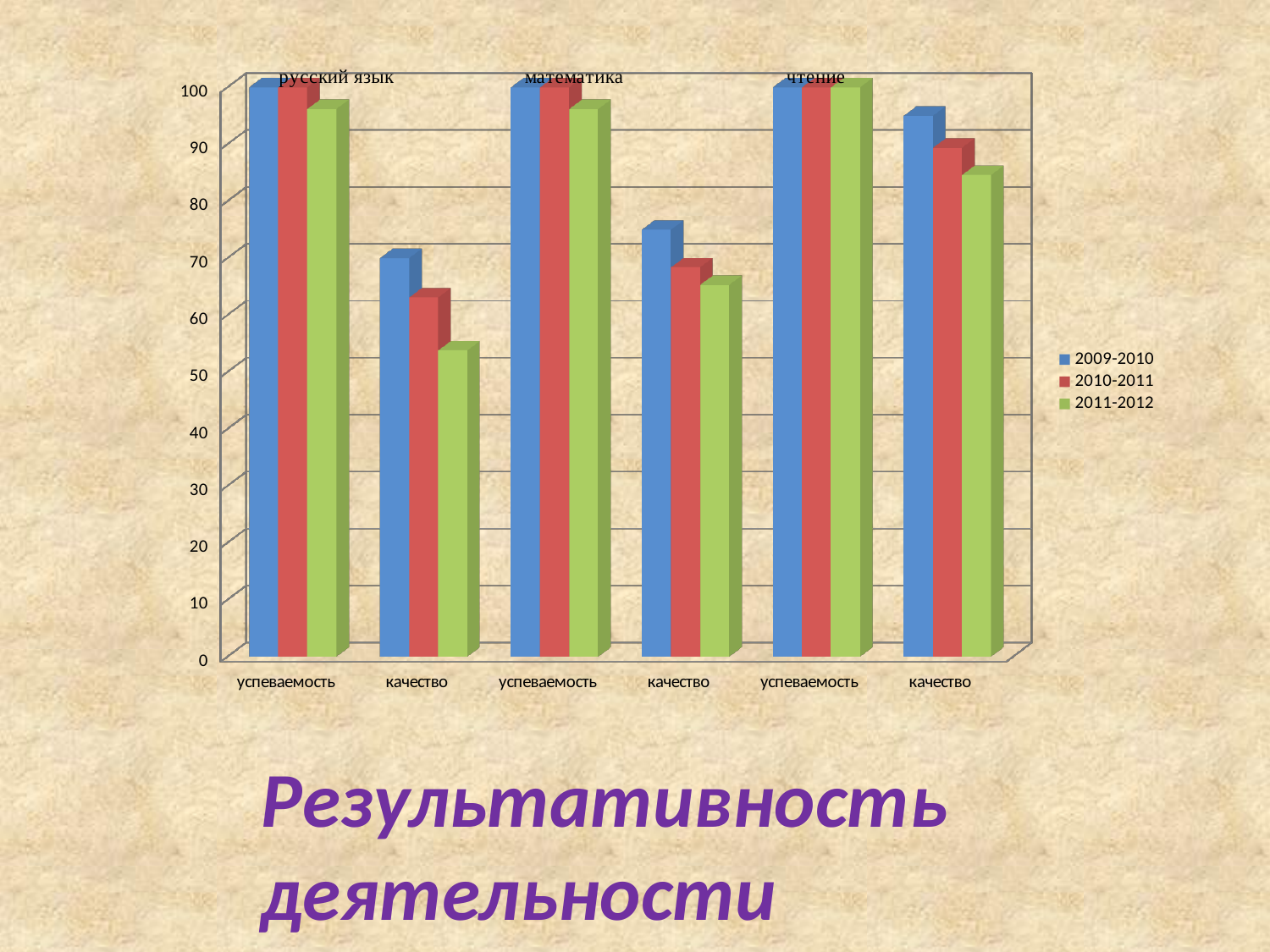
How many series does the legend list? 3 Among the качество categories, which subject has the lowest value for 2011-2012? русский язык Is the value for качество in чтение for 2011-2012 greater or less than 80? greater Which series are listed in the legend? 2009-2010, 2010-2011, 2011-2012 What is the title written below the chart? Результативность деятельности Is the value for качество in математика for 2011-2012 greater or less than 70? less Is the value for качество in чтение for 2009-2010 greater or less than 90? greater For качество in русский язык, which is larger: the 2009-2010 value or the 2011-2012 value? 2009-2010 How many categories are shown along the x axis? 6 What kind of chart is shown on the slide? bar chart For качество in математика, do the values rise or fall from 2009-2010 to 2011-2012? fall